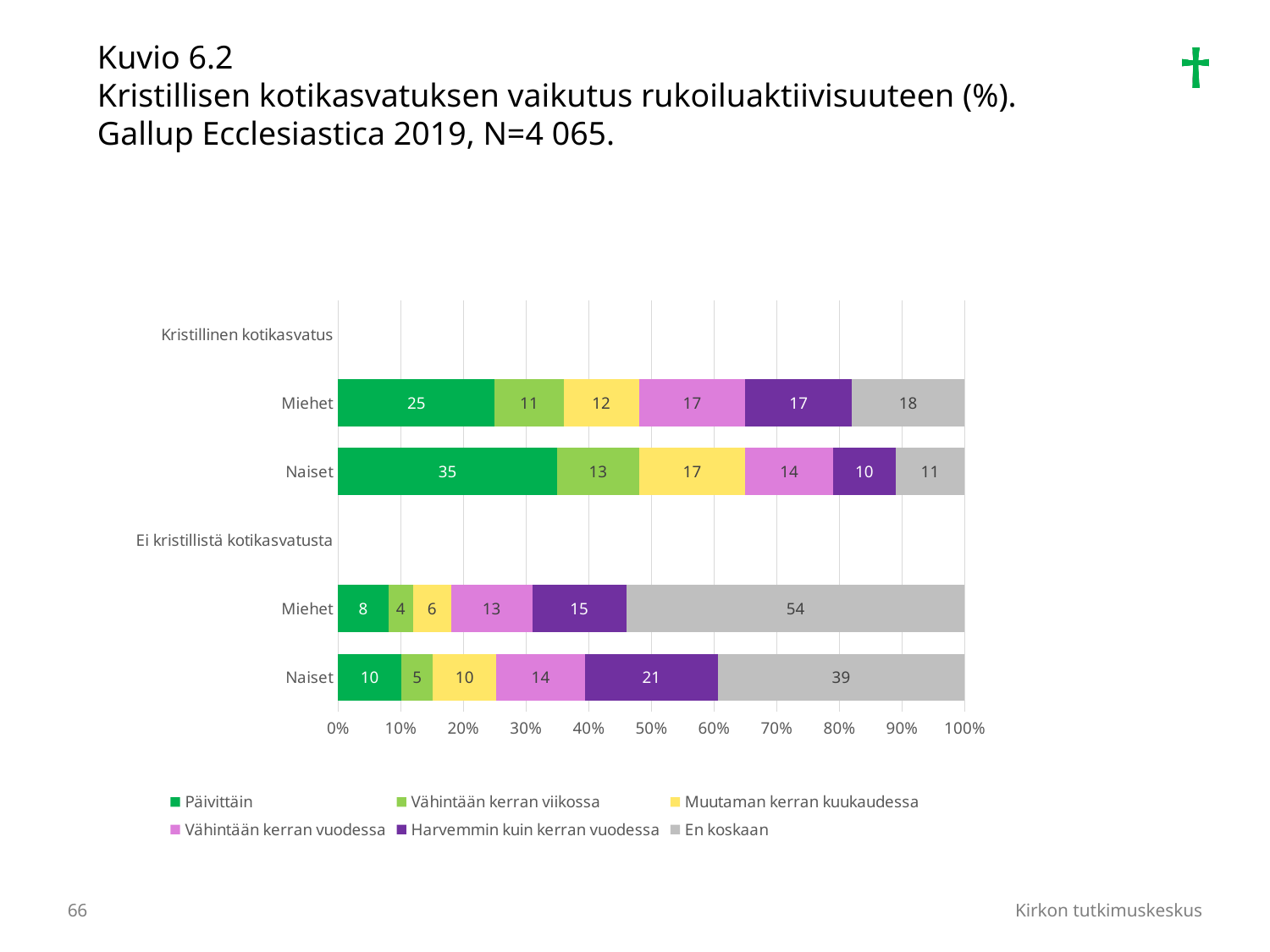
What kind of chart is shown on the slide? Stacked bar chart What is the Harvemmin kuin kerran vuodessa value for Naiset in the Ei kristillistä kotikasvatusta group? 21 What is the En koskaan value for Miehet in the Ei kristillistä kotikasvatusta group? 54 How many series does the legend list? 6 What is the Päivittäin value for Naiset in the Kristillinen kotikasvatus group? 35 What is the difference between the En koskaan values for Miehet and Naiset in the Ei kristillistä kotikasvatusta group? 15 What is the Muutaman kerran kuukaudessa value for Miehet in the Kristillinen kotikasvatus group? 12 Which bar has the lowest Vähintään kerran viikossa value? Miehet (Ei kristillistä kotikasvatusta) What is the total of the stacked bar for Miehet in the Kristillinen kotikasvatus group? 100 Which bar has the highest Päivittäin value? Naiset (Kristillinen kotikasvatus) What is the title of the chart? Kuvio 6.2 Kristillisen kotikasvatuksen vaikutus rukoiluaktiivisuuteen (%). Gallup Ecclesiastica 2019, N=4 065. Which is larger: the Päivittäin value for Miehet with Kristillinen kotikasvatus or for Miehet with Ei kristillistä kotikasvatusta? Miehet with Kristillinen kotikasvatus